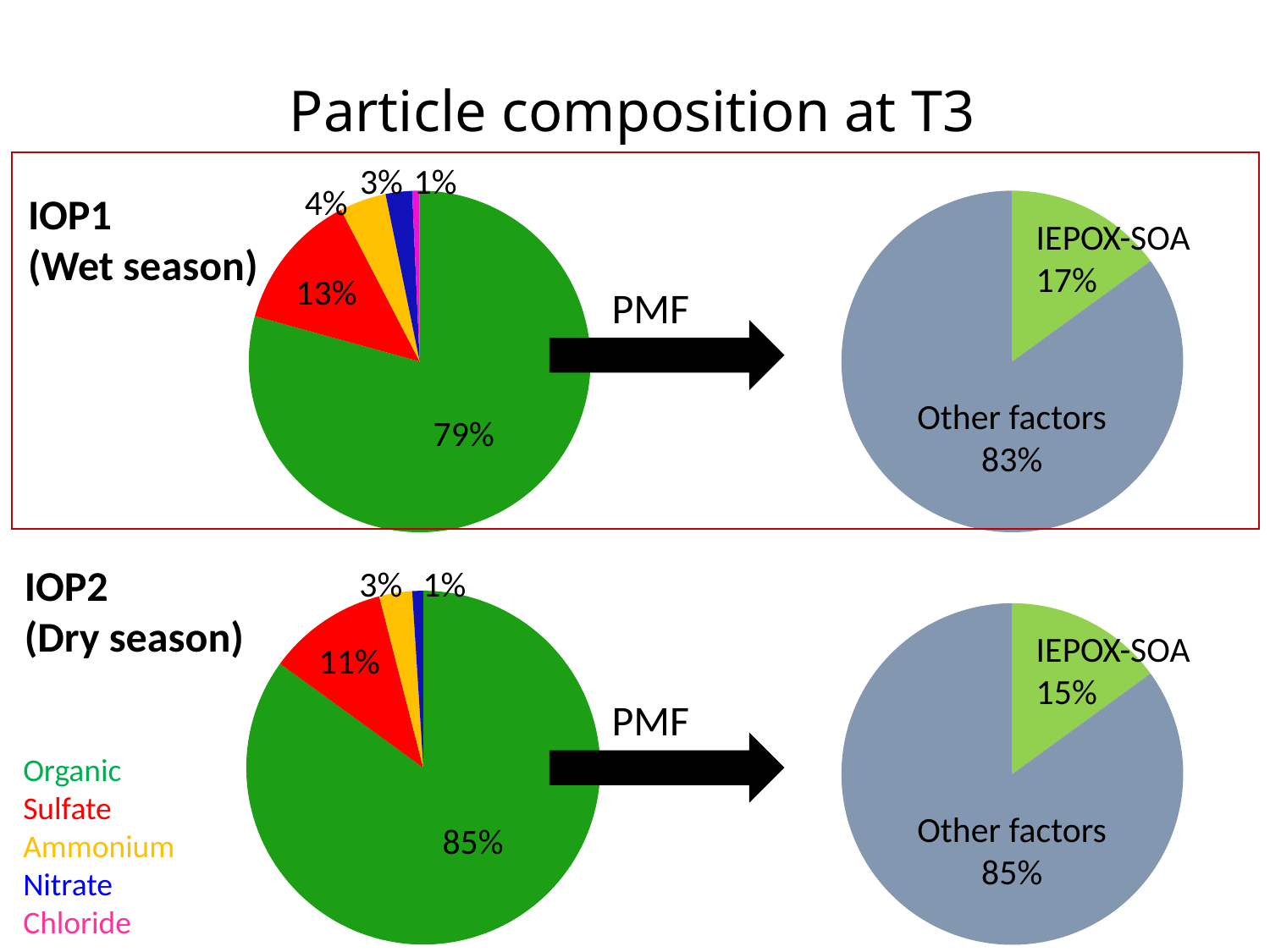
In the IOP2 (Dry season) composition pie chart on the left, what share is Sulfate? 11% In the IOP1 (Wet season) PMF pie chart on the right, what share is IEPOX-SOA? 17% In the IOP1 (Wet season) composition pie chart on the left, what share is Sulfate? 13% In the IOP1 (Wet season) composition pie chart on the left, what share is Organic? 79% How many components does the legend at the bottom left of the slide list? 5 What type of chart is used to show the particle composition at T3? Pie chart In the IOP2 (Dry season) PMF pie chart on the right, what share is Other factors? 85% In the IOP1 (Wet season) composition pie chart on the left, what share is Ammonium? 4% In the IOP2 (Dry season) composition pie chart on the left, what share is Organic? 85% What is the difference between the Sulfate share in the IOP1 (Wet season) composition pie and the Sulfate share in the IOP2 (Dry season) composition pie? 2% In the IOP2 (Dry season) composition pie chart on the left, which is larger, Sulfate or Ammonium? Sulfate In the IOP1 (Wet season) composition pie chart on the left, which component has the largest share? Organic